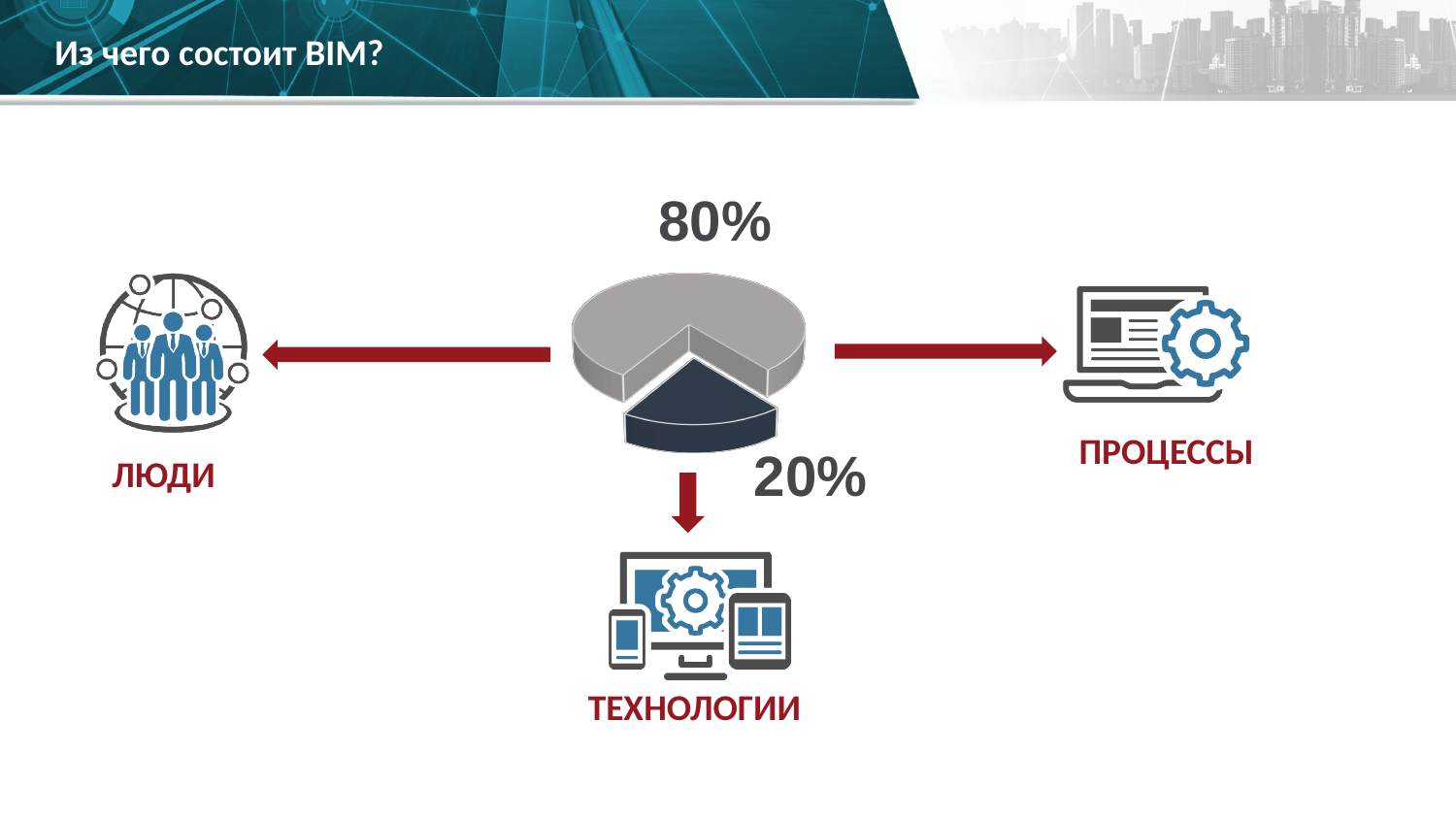
Which label does the downward arrow from the 20% slice point to? ТЕХНОЛОГИИ What is the title of the slide containing the pie chart? Из чего состоит BIM? What is the value of the smaller, separated slice of the pie chart? 20% Which slice is larger: the 80% slice or the 20% slice? the 80% slice What is the difference between the two slice values in the pie chart? 60% What is the total of the two slice values shown on the pie chart? 100% What percentage is shown for the slice that the arrow links to ТЕХНОЛОГИИ? 20% What kind of chart is shown on the slide? pie chart What is the value of the larger slice of the pie chart? 80% What share of the pie does the dark, separated slice represent? 20% Is the value of the larger slice greater or less than 50%? greater How many slices does the pie chart have? 2